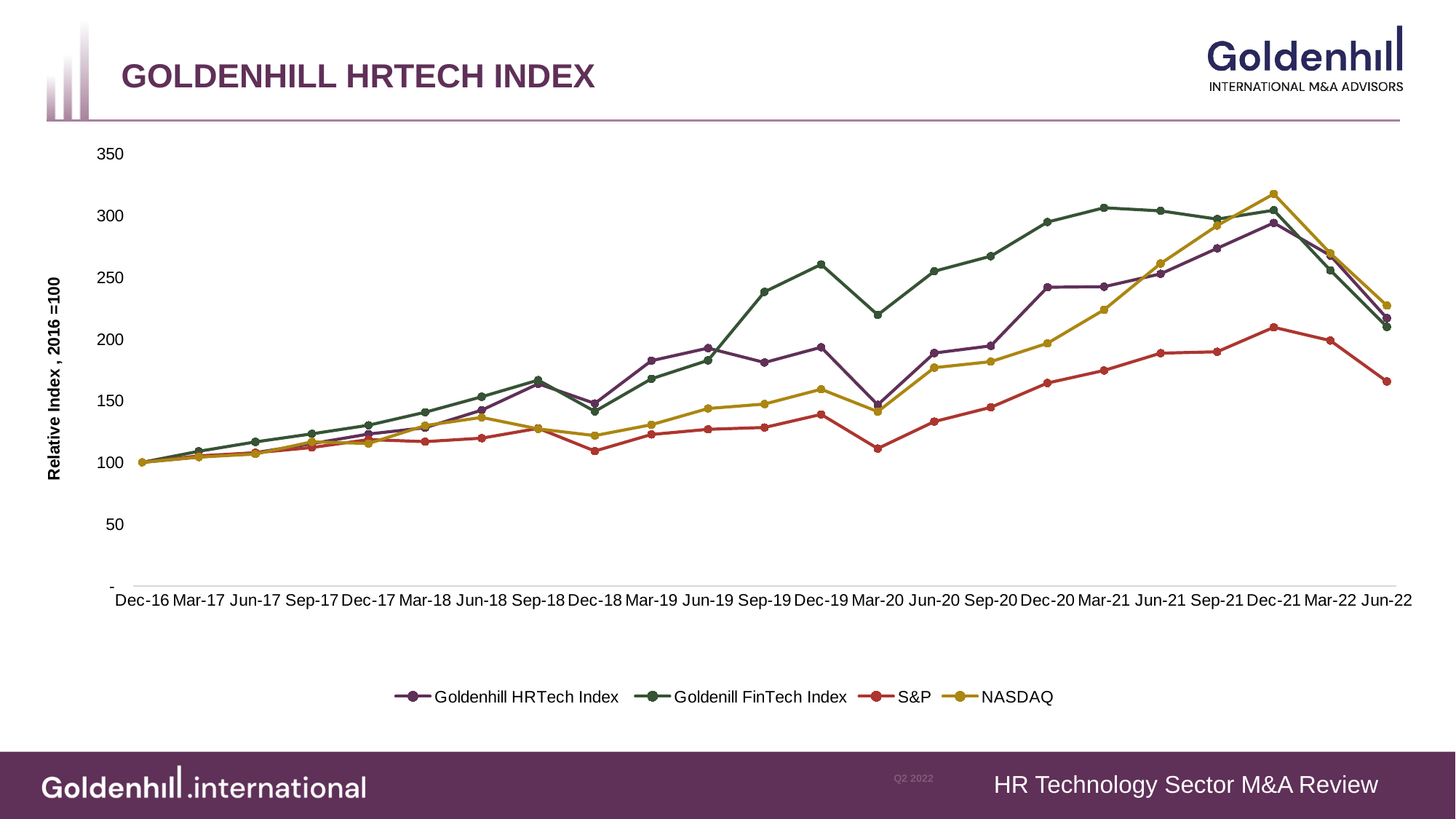
Is the value for S&P at Dec-18 greater or less than 150? less Is the value for NASDAQ at Dec-21 greater or less than 300? greater At Sep-19, which is larger: the Goldenill FinTech Index or the Goldenhill HRTech Index? Goldenill FinTech Index How many series does the legend list? 4 Is the value for the Goldenill FinTech Index at Sep-19 greater or less than 200? greater Which series has the lowest value at Jun-22? S&P Does the Goldenhill HRTech Index rise or fall from Dec-21 to Jun-22? fall What is the value of the Goldenhill HRTech Index at Dec-16? 100 How many time points are plotted along the x axis? 23 Which series has the highest value at Dec-21? NASDAQ What kind of chart is shown on the slide? line chart